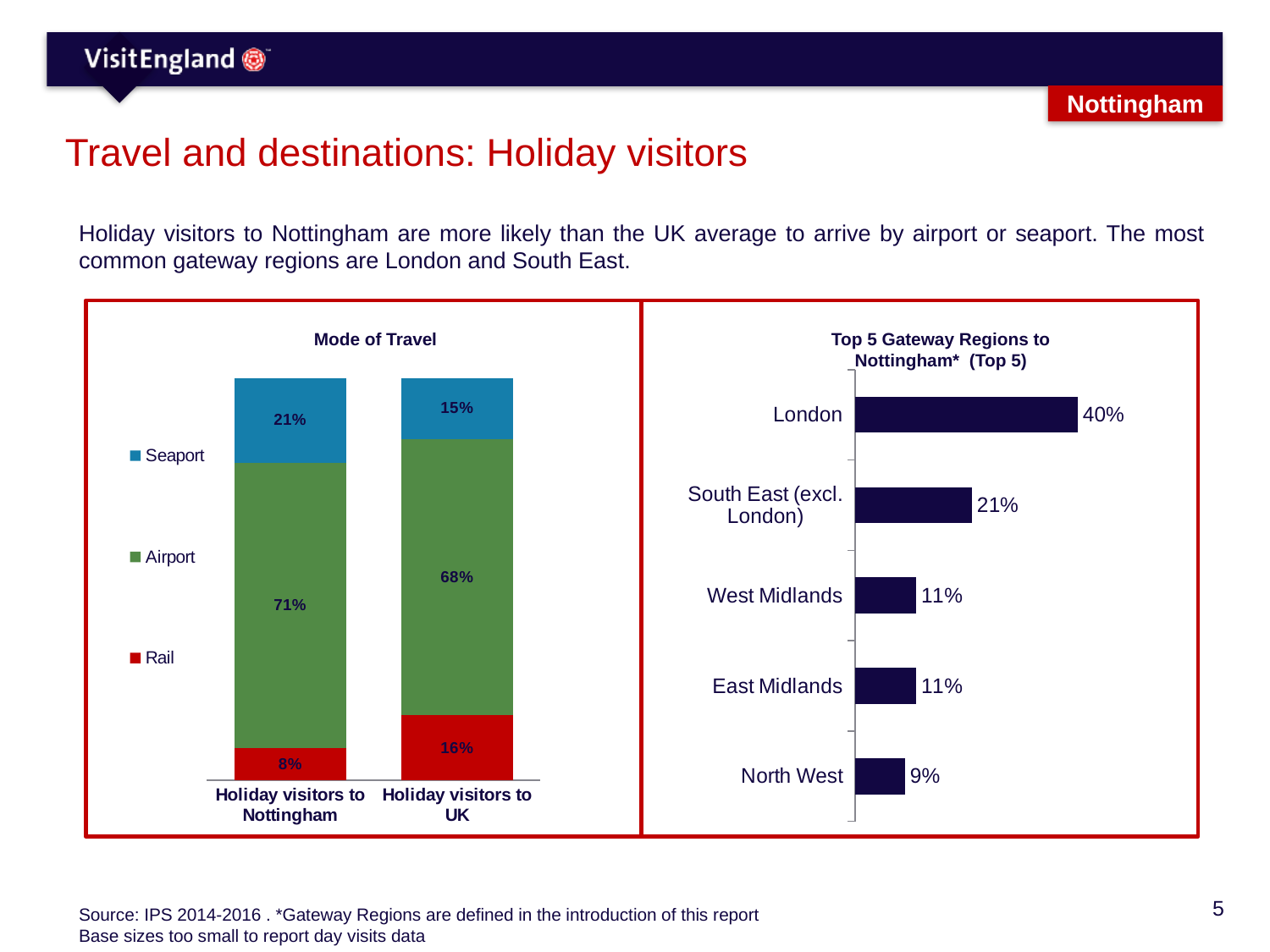
What kind of chart is the Mode of Travel chart? Stacked bar chart In the Top 5 Gateway Regions to Nottingham chart, which region has the lowest value? North West In the Top 5 Gateway Regions to Nottingham chart, what is the difference between London and West Midlands? 29 percentage points In the Mode of Travel chart, what percentage of holiday visitors to Nottingham arrive by airport? 71% In the Mode of Travel chart, what is the total of the stacked bar for holiday visitors to Nottingham? 100% In the Mode of Travel chart, what is the difference between the seaport share for holiday visitors to Nottingham and for holiday visitors to the UK? 6 percentage points In the Mode of Travel chart, which is larger: the rail share for holiday visitors to Nottingham or for holiday visitors to the UK? Holiday visitors to UK In the Mode of Travel chart, what percentage of holiday visitors to the UK arrive by rail? 16% How many series does the legend of the Mode of Travel chart list? 3 In the Mode of Travel chart, what is the seaport share for holiday visitors to Nottingham? 21% In the Top 5 Gateway Regions to Nottingham chart, what is the value for South East (excl. London)? 21% In the Top 5 Gateway Regions to Nottingham chart, which region has the highest value? London